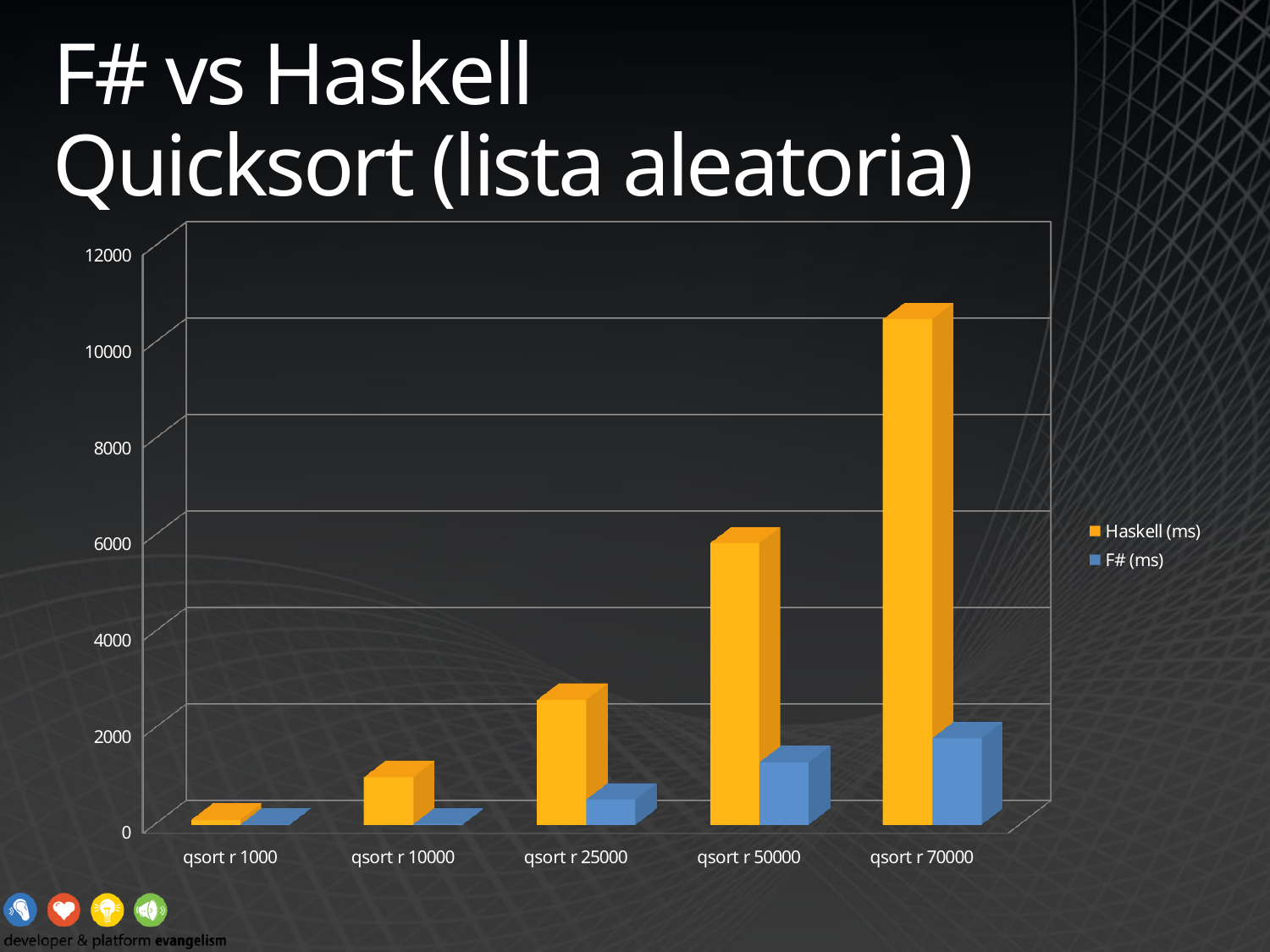
Is the Haskell (ms) value for qsort r 25000 greater or less than 2000? greater Which two series are listed in the chart's legend? Haskell (ms) and F# (ms) For qsort r 50000, which series has the larger value, Haskell (ms) or F# (ms)? Haskell (ms) Is the Haskell (ms) value for qsort r 50000 greater or less than 4000? greater Which category has the highest Haskell (ms) value? qsort r 70000 Which category has the lowest Haskell (ms) value? qsort r 1000 Do the Haskell (ms) values rise or fall as you move from qsort r 1000 to qsort r 70000 along the x axis? rise How many categories are shown on the x axis of the chart? 5 What kind of chart is shown on the slide? bar chart How many series does the chart's legend list? 2 Is the Haskell (ms) value for qsort r 70000 greater or less than 10000? greater